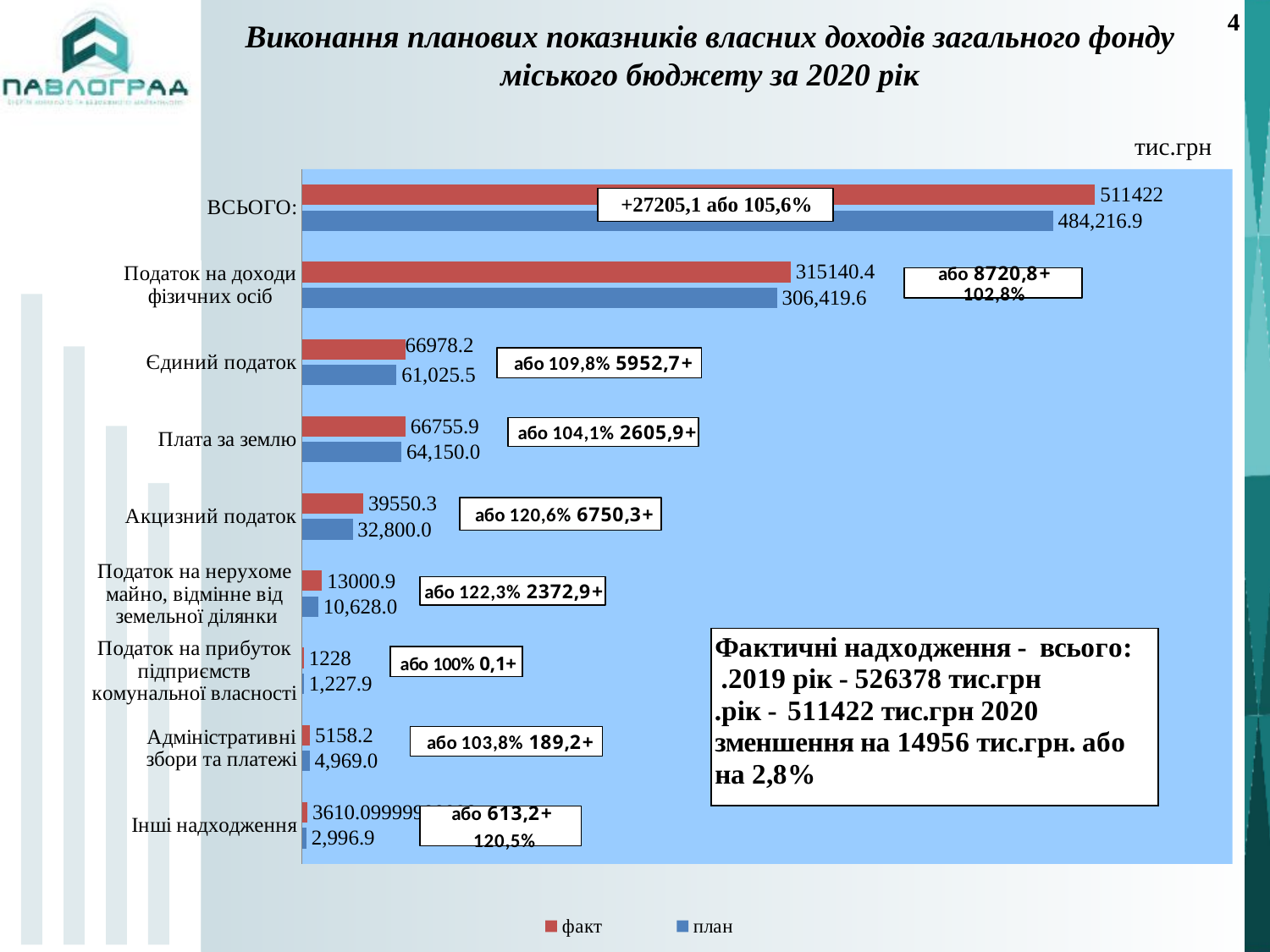
Which category has the lowest план value? Податок на прибуток підприємств комунальної власності What is the факт value for Адміністративні збори та платежі? 5158.2 What is the план value for ВСЬОГО? 484,216.9 How many series does the legend list? 2 How many categories are shown on the chart? 9 Which is larger: the факт value for Єдиний податок or the факт value for Плата за землю? Єдиний податок What is the факт value for ВСЬОГО? 511422 What type of chart is shown on the slide? bar chart What is the план value for Акцизний податок? 32,800.0 What is the difference between the факт and план values for Акцизний податок? 6750.3 Which colour represents the план series in the legend? blue What is the факт value for Податок на доходи фізичних осіб? 315140.4